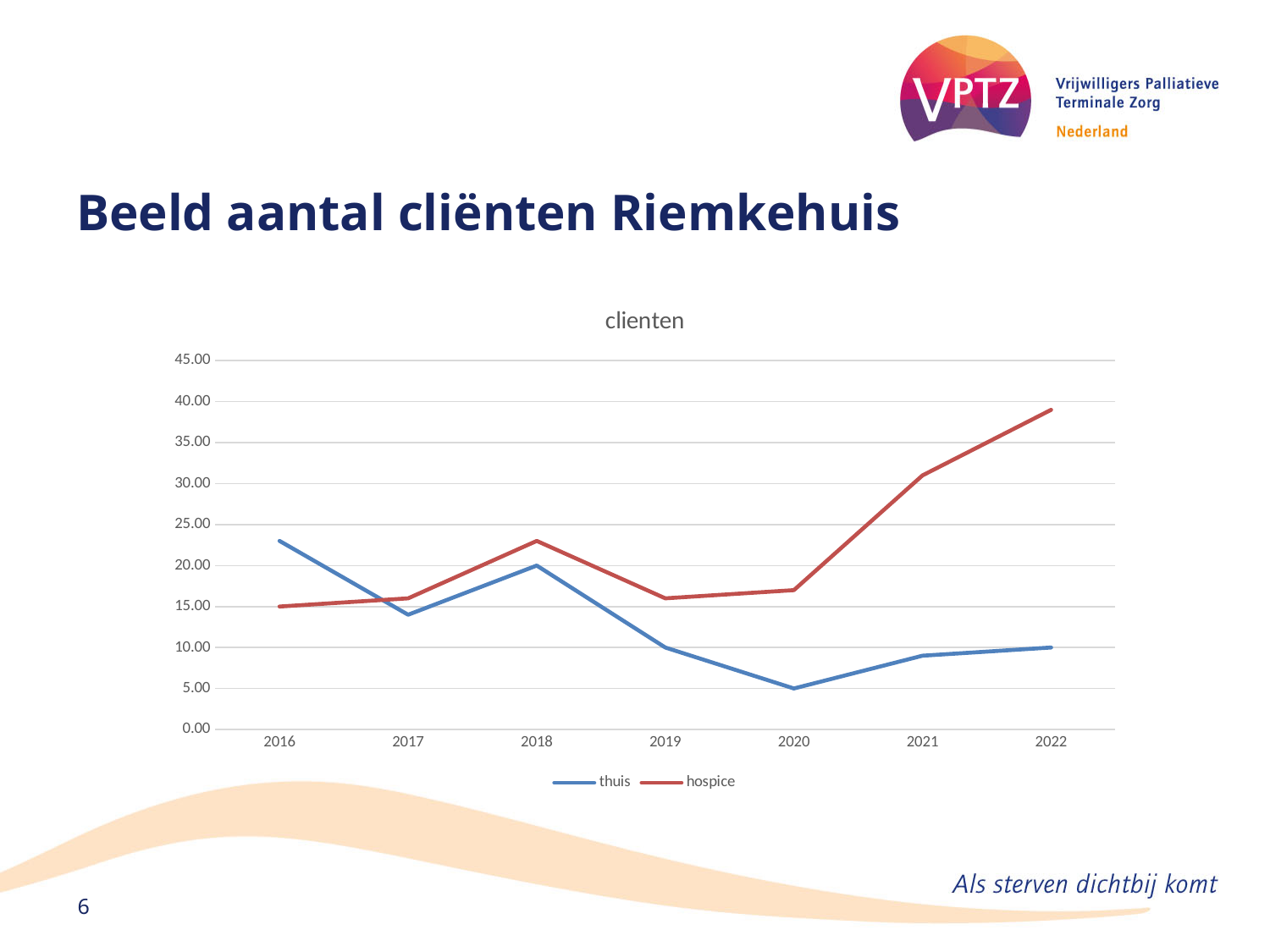
In which year does the thuis series reach its lowest value? 2020 Is the value for thuis in 2016 greater or less than 20.00? greater What kind of chart is shown on the slide? line chart Is the value for hospice in 2022 greater or less than 35.00? greater How many series does the legend list? 2 What is the value for thuis in 2020? 5.00 In 2016, which series has the larger value, thuis or hospice? thuis What is the title shown above the chart? clienten In 2022, which series has the larger value, thuis or hospice? hospice Does the hospice series rise or fall from 2020 to 2022? rise How many years are plotted along the x axis? 7 In which year does the hospice series reach its highest value? 2022